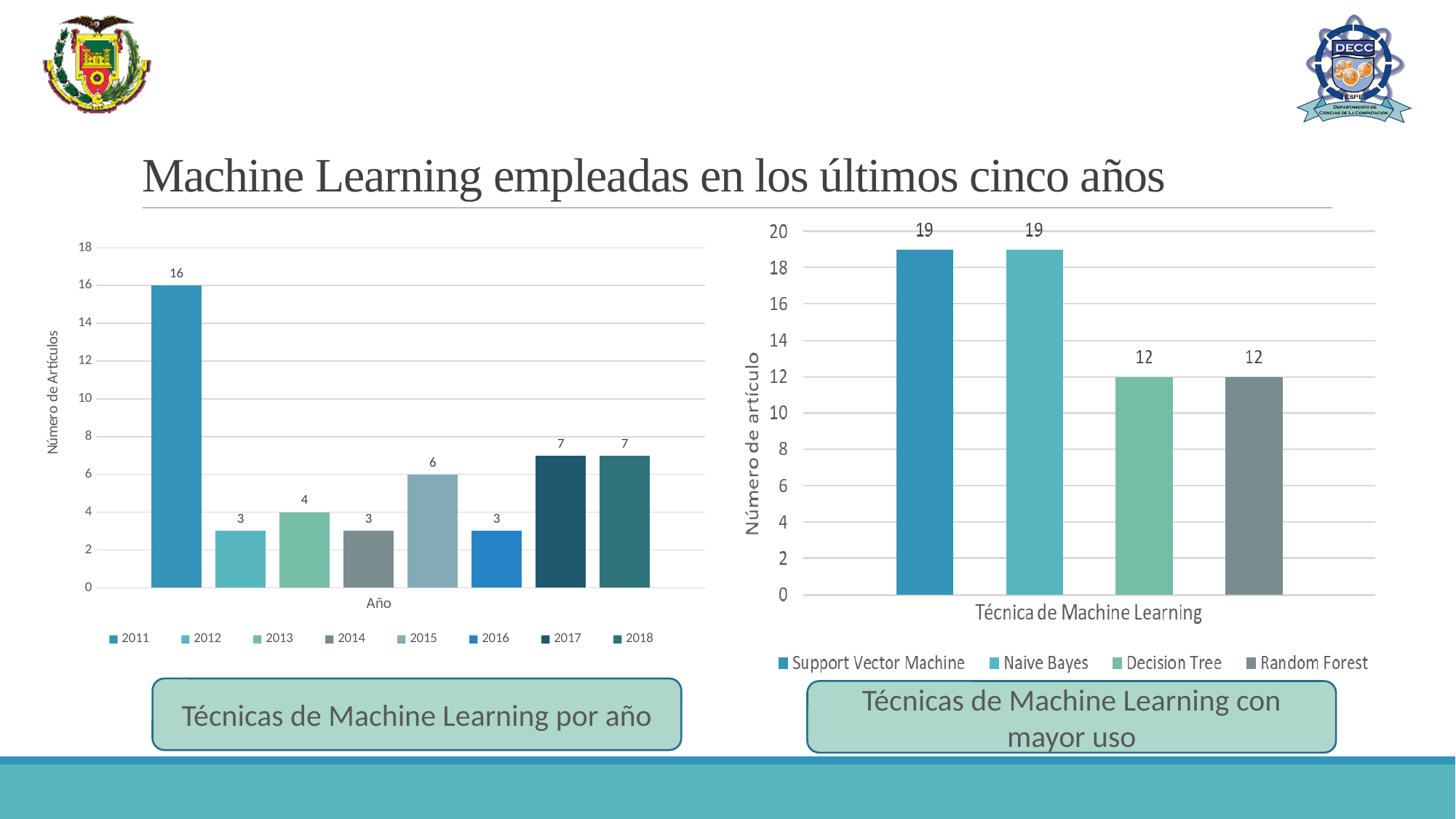
In the right chart (Técnicas de Machine Learning con mayor uso), what is the difference between the values for Support Vector Machine and Random Forest? 7 In the left chart (Técnicas de Machine Learning por año), which is larger, the value for 2013 or the value for 2017? 2017 In the left chart (Técnicas de Machine Learning por año), what is the value for 2015? 6 In the right chart (Técnicas de Machine Learning con mayor uso), how many entries does the legend list? 4 In the left chart (Técnicas de Machine Learning por año), what is the value for 2011? 16 What kind of chart is the right chart (Técnicas de Machine Learning con mayor uso)? Bar chart In the right chart (Técnicas de Machine Learning con mayor uso), what is the value for Decision Tree? 12 In the left chart (Técnicas de Machine Learning por año), what is the difference between the values for 2011 and 2018? 9 In the left chart (Técnicas de Machine Learning por año), which year has the highest value? 2011 What is the y-axis label of the left chart (Técnicas de Machine Learning por año)? Número de Artículos In the left chart (Técnicas de Machine Learning por año), how many years are shown? 8 In the right chart (Técnicas de Machine Learning con mayor uso), what is the value for Naive Bayes? 19